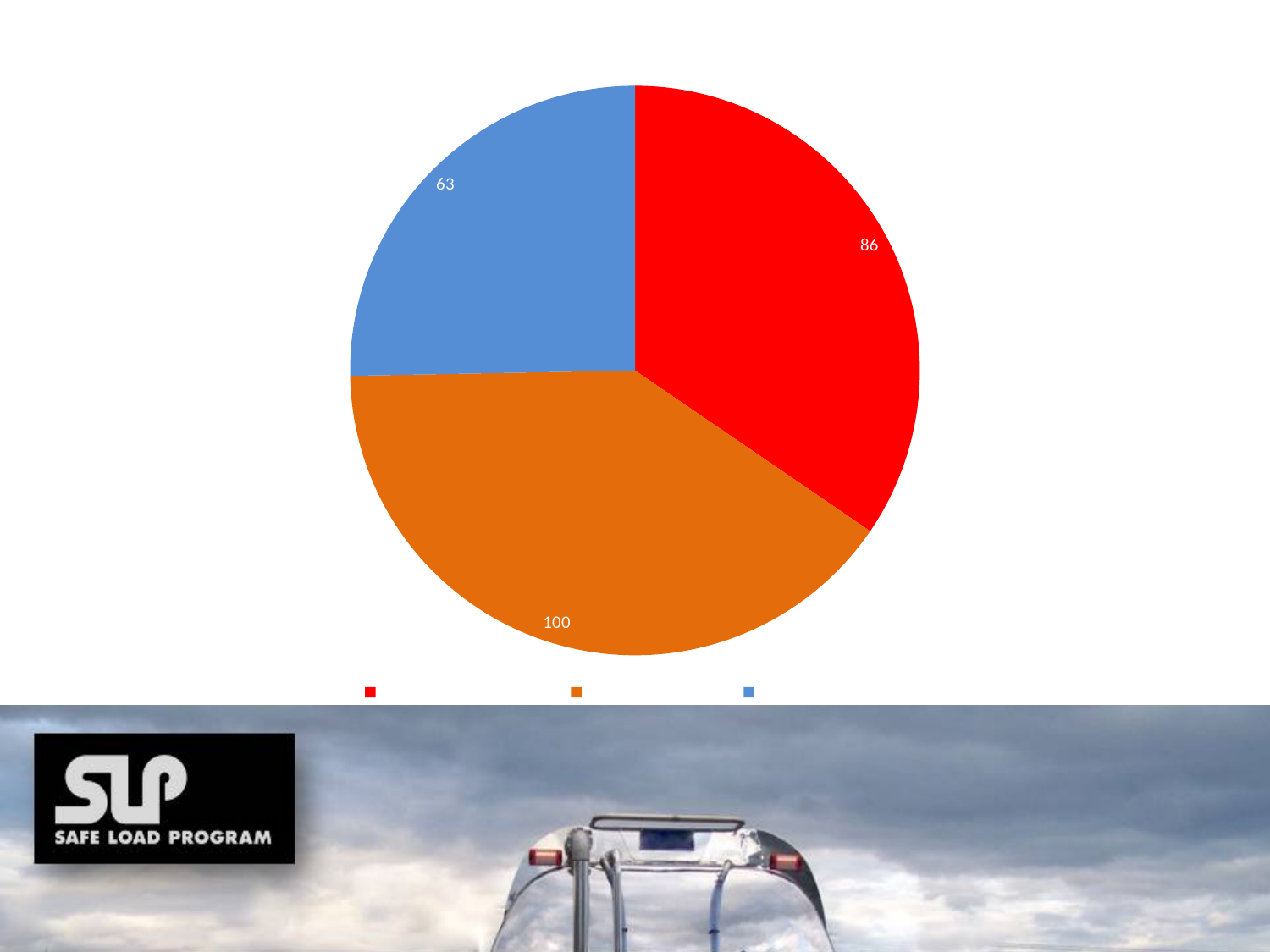
How many slices does the pie chart have? 3 Which slice of the pie chart has the smallest value? The blue slice (63) What is the total of all three slice values in the pie chart? 249 Which slice of the pie chart has the largest value? The orange slice (100) Which is larger, the red slice or the blue slice? The red slice What value is shown on the blue slice of the pie chart? 63 How many entries does the legend below the chart show? 3 What is the difference between the orange slice and the blue slice values? 37 What type of chart is shown on the slide? Pie chart What value is shown on the red slice of the pie chart? 86 What is the difference between the orange slice and the red slice values? 14 What value is shown on the orange slice of the pie chart? 100